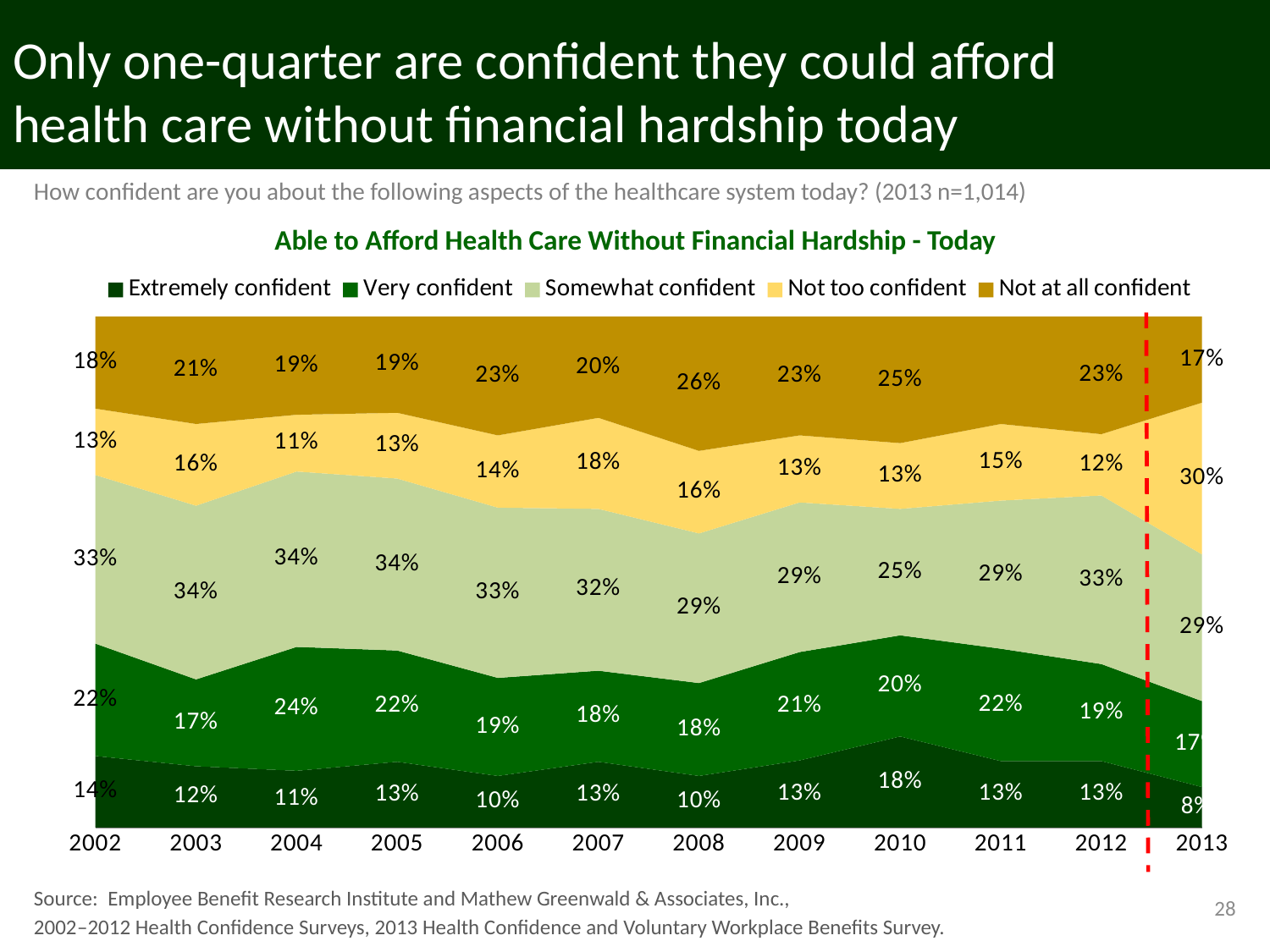
Does the "Somewhat confident" share rise or fall from 2005 to 2010? Fall How many years are shown on the x axis? 12 In which year was the "Not at all confident" share highest? 2008 What is the "Not too confident" value for 2013? 30% How many series does the legend list? 5 Which year had a larger "Very confident" share, 2003 or 2004? 2004 What percentage of respondents were "Not at all confident" in 2008? 26% By how many percentage points did the "Somewhat confident" share fall from 2002 to 2010? 8 percentage points In which year was the "Extremely confident" share highest? 2010 What kind of chart is shown on the slide? Stacked area chart What is the "Somewhat confident" value for 2013? 29% What is the "Extremely confident" value for 2010? 18%